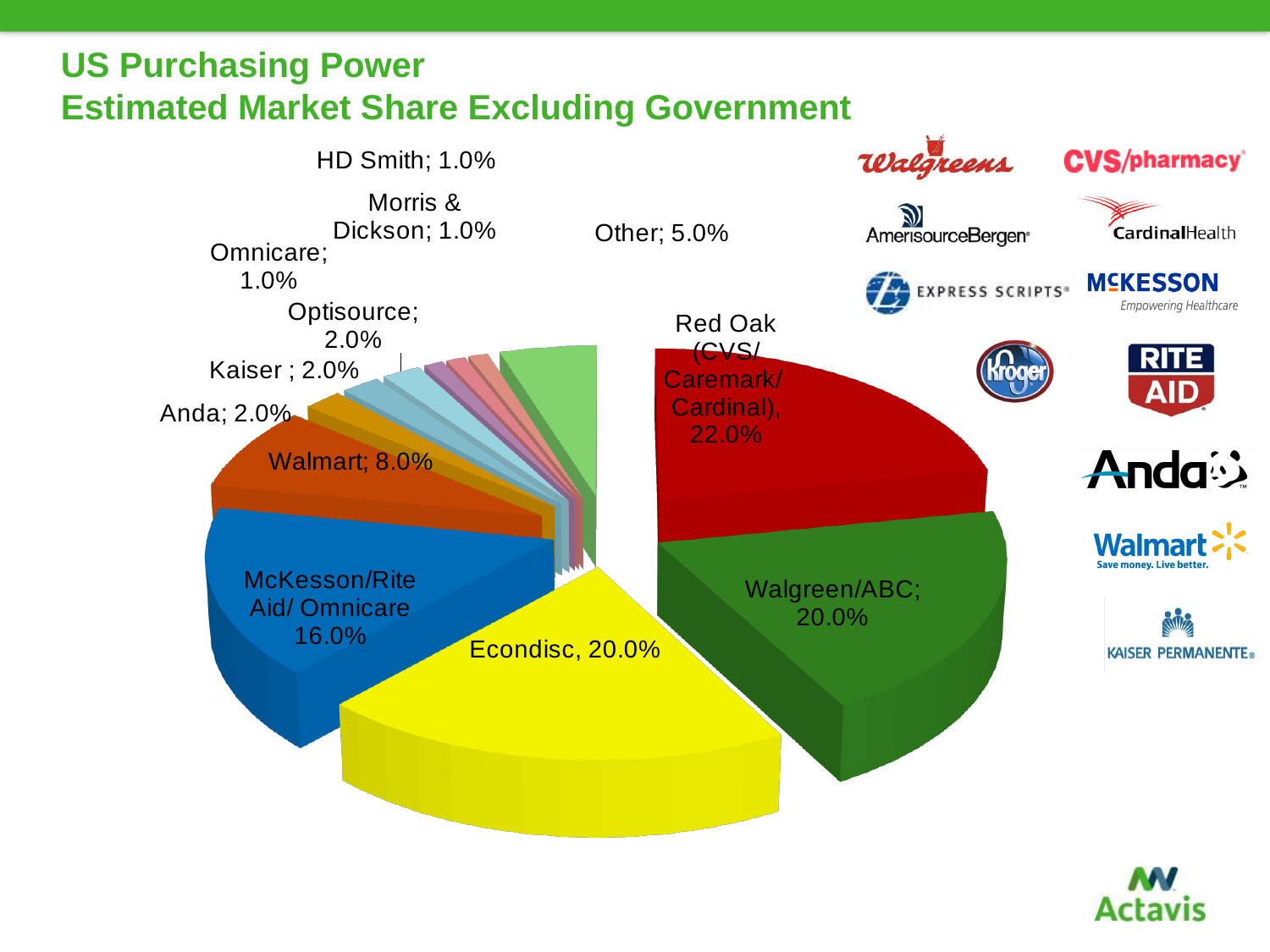
How many slices does the pie chart have? 12 Which has a larger market share, Walmart or Anda? Walmart What is the market share for Walmart? 8.0% What is the market share for McKesson/Rite Aid/Omnicare? 16.0% What type of chart is shown on the slide? pie chart What is the market share for Optisource? 2.0% What is the title of the chart on the slide? US Purchasing Power Estimated Market Share Excluding Government What is the difference in market share between Red Oak (CVS/Caremark/Cardinal) and McKesson/Rite Aid/Omnicare? 6.0% What share of the pie does Econdisc hold? 20.0% What is the market share for Red Oak (CVS/Caremark/Cardinal)? 22.0% Which category has the largest share of the pie? Red Oak (CVS/Caremark/Cardinal) What is the market share for Other? 5.0%